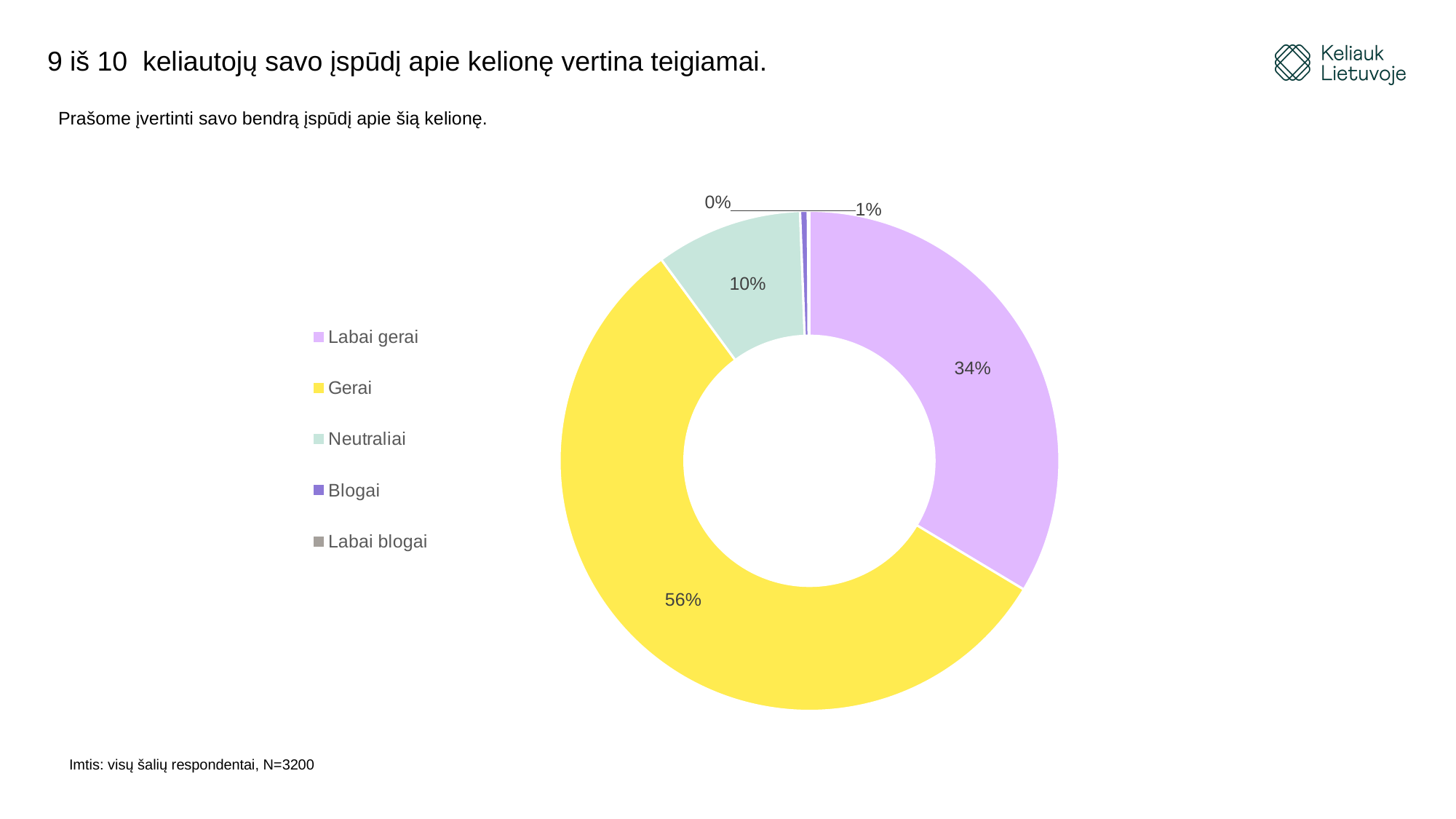
What is the difference in percentage points between "Gerai" and "Labai gerai"? 22 What kind of chart is shown on the slide? Pie (donut) chart What colour is the "Gerai" slice? Yellow Which category has the largest share of the chart? Gerai What share of respondents answered "Neutraliai"? 10% What share of respondents answered "Labai blogai"? 0% Which is larger, the share for "Labai gerai" or the share for "Neutraliai"? Labai gerai What share of respondents answered "Gerai"? 56% What share of respondents answered "Blogai"? 1% What share of respondents answered "Labai gerai"? 34% Which category has the smallest share of the chart? Labai blogai How many categories does the legend list? 5